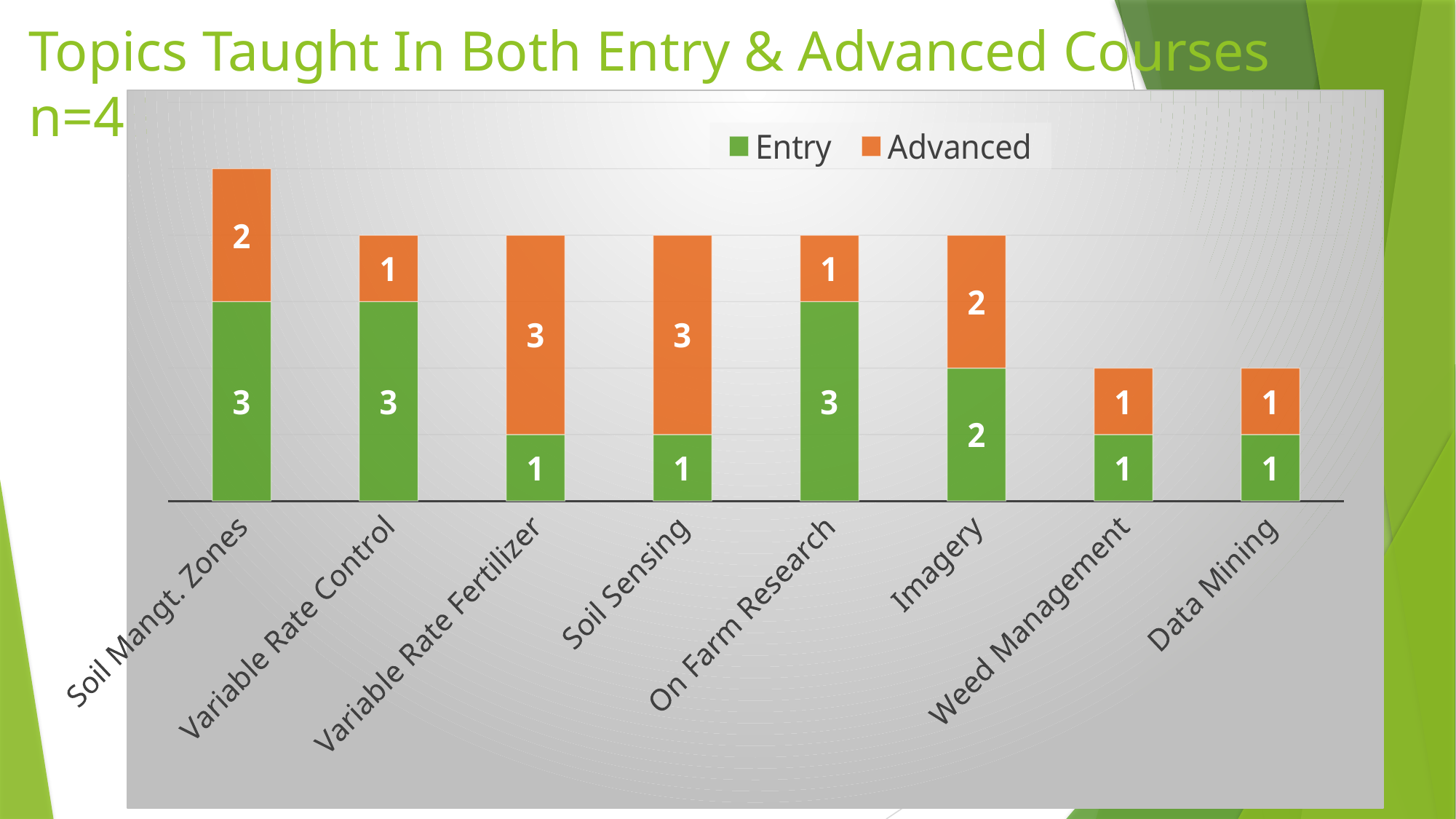
How many series does the legend list? 2 Which is larger, the Entry value for Imagery or the Entry value for Soil Sensing? Entry value for Imagery What kind of chart is shown on the slide? Stacked bar chart What is the Advanced value for On Farm Research? 1 What is the difference between the Advanced value for Soil Sensing and the Advanced value for Data Mining? 2 What is the Entry value for Variable Rate Fertilizer? 1 How many categories are shown on the x axis? 8 What is the Advanced value for Imagery? 2 Which category has the highest total stacked bar? Soil Mangt. Zones What is the total of the stacked bar for Soil Mangt. Zones? 5 What is the total of the stacked bar for Weed Management? 2 What is the Entry value for Soil Mangt. Zones? 3